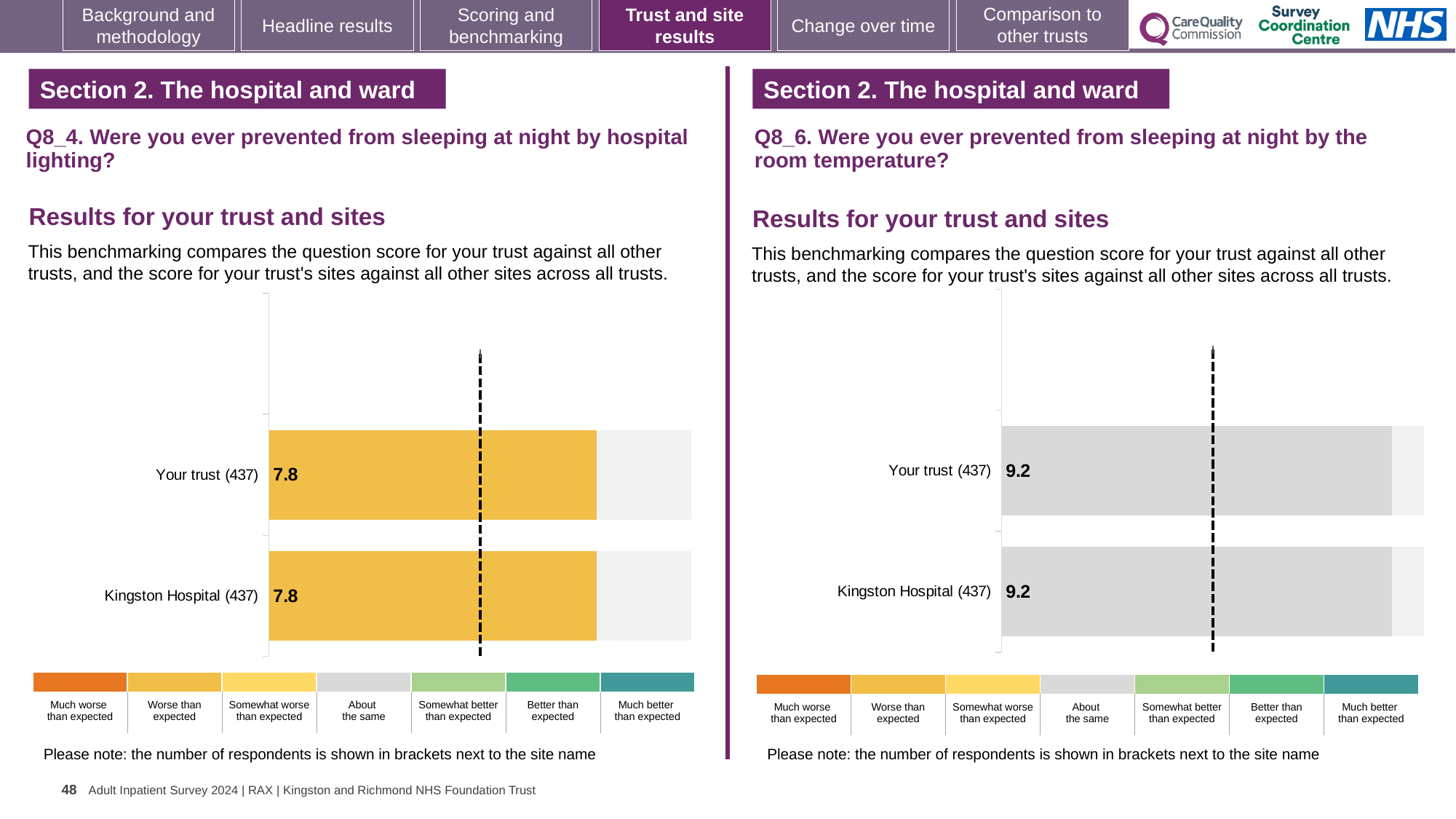
On the Q8_4 hospital lighting chart, what is the difference between the Your trust score and the Kingston Hospital score? 0.0 On the Q8_4 hospital lighting chart, which benchmark category does the colour of the bars correspond to? Worse than expected Which is larger: the Your trust score on the Q8_4 hospital lighting chart or the Your trust score on the Q8_6 room temperature chart? Q8_6 room temperature On the Q8_6 room temperature chart, which benchmark category does the colour of the bars correspond to? About the same On the Q8_6 room temperature chart, what is the score for Kingston Hospital (437)? 9.2 On the Q8_4 hospital lighting chart, what is the score for Your trust (437)? 7.8 How many bars are plotted on the Q8_6 room temperature chart? 2 How many bars are plotted on the Q8_4 hospital lighting chart? 2 What kind of chart is used for the Q8_4 hospital lighting results? Bar chart On the Q8_6 room temperature chart, what is the difference between the Your trust score and the Kingston Hospital score? 0.0 On the Q8_4 hospital lighting chart, what is the score for Kingston Hospital (437)? 7.8 On the Q8_6 room temperature chart, what is the score for Your trust (437)? 9.2